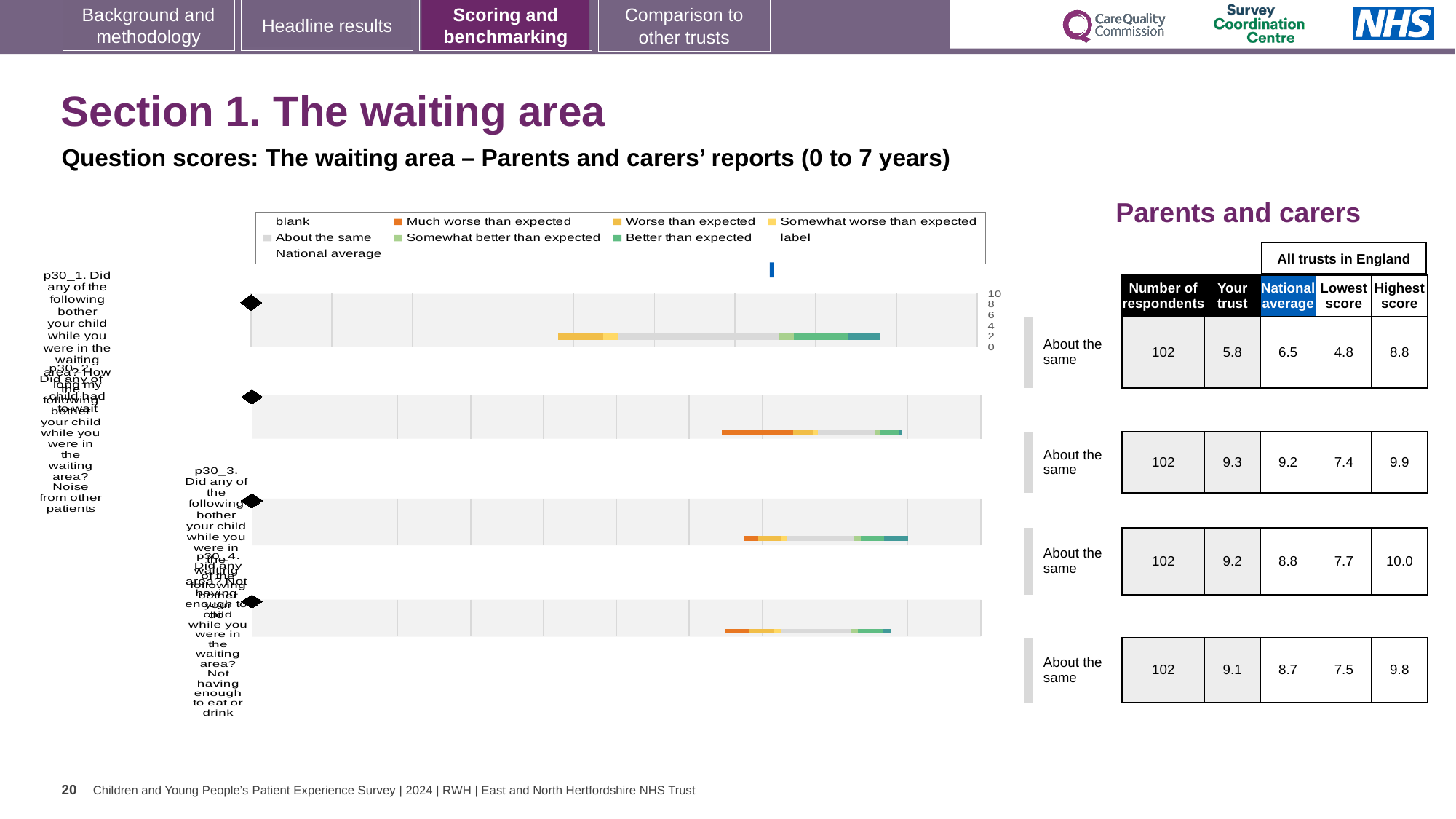
In the table beside the chart, what is the national average for the second question (p30_2)? 9.2 How many respondents are listed for each question in the table beside the chart? 102 For the third question row, which is larger: the 'Your trust' score or the national average? Your trust (9.2) In the table beside the chart, what is the 'Your trust' score for the first question (p30_1)? 5.8 Which question row has the highest 'Your trust' score in the table beside the chart? the second row (p30_2), 9.3 Which question row has the lowest 'Your trust' score in the table beside the chart? the first row (p30_1), 5.8 How many entries does the chart legend list? 9 How many question bars are plotted in the chart? 4 For the first question row, what is the difference between the highest score (8.8) and the lowest score (4.8) in the table? 4.0 What kind of chart is shown on the slide? bar chart What benchmark category is shown next to each of the four bars in the chart? About the same In the table beside the chart, what is the highest score across all trusts in England for the third question (p30_3)? 10.0